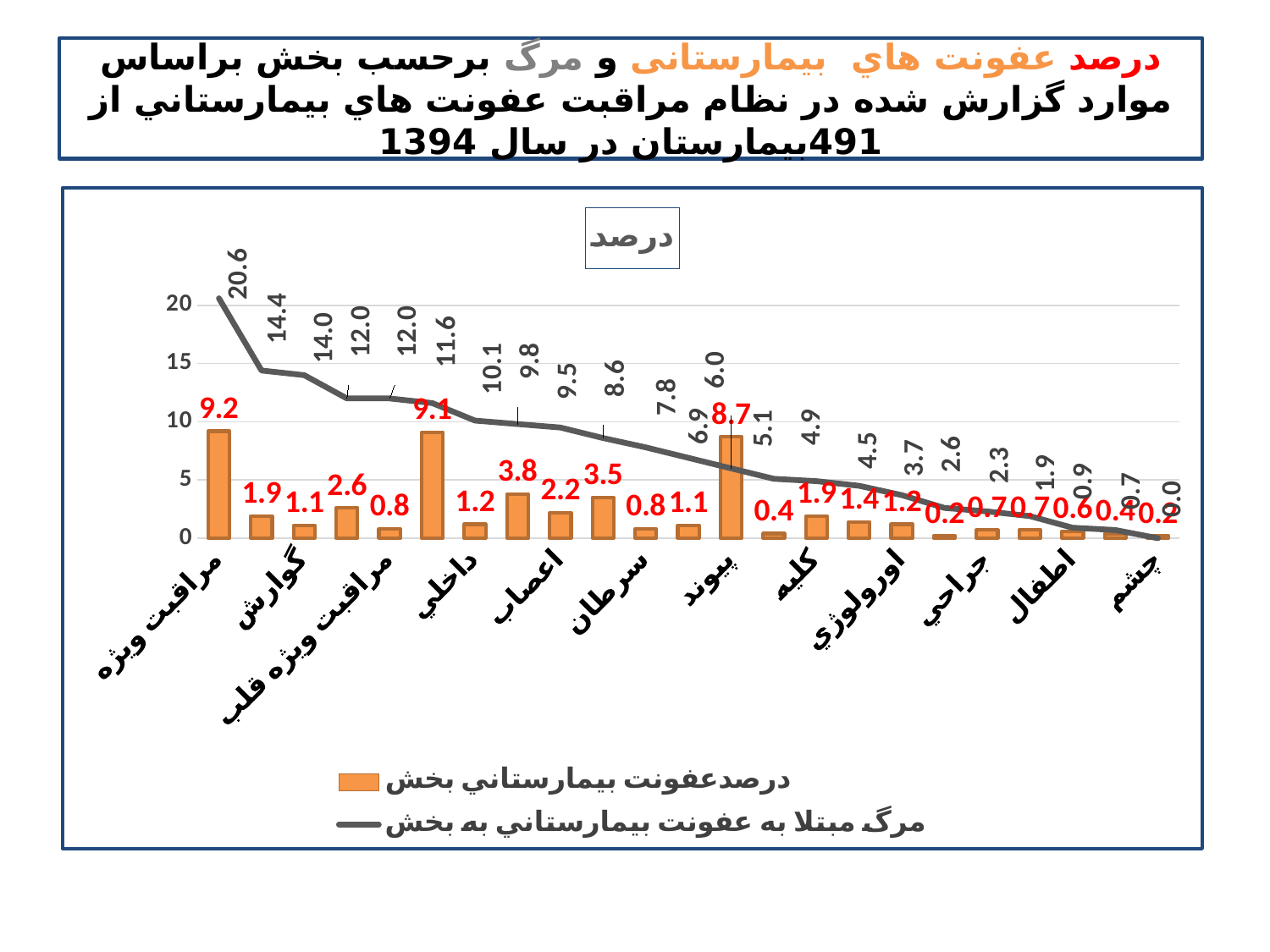
Does the line series rise or fall from left to right along the x axis? Falls Which category has the lowest value in the line series? چشم What is the value of the bar series for چشم? 0.2 What colour are the bars in the chart? Orange Which category has the highest value in the line series? مراقبت ویژه What is the value of the line series (مرگ مبتلا به عفونت بیمارستانی به بخش) for مراقبت ویژه? 20.6 What is the highest value shown in the bar series? 9.2 What is the difference between the line values for مراقبت ویژه and چشم? 20.6 What type of chart is shown on the slide? Combined bar and line chart What is the value of the line series for چشم? 0.0 How many series does the legend list? 2 What is the value of the bar series (درصدعفونت بیمارستانی بخش) for مراقبت ویژه? 9.2